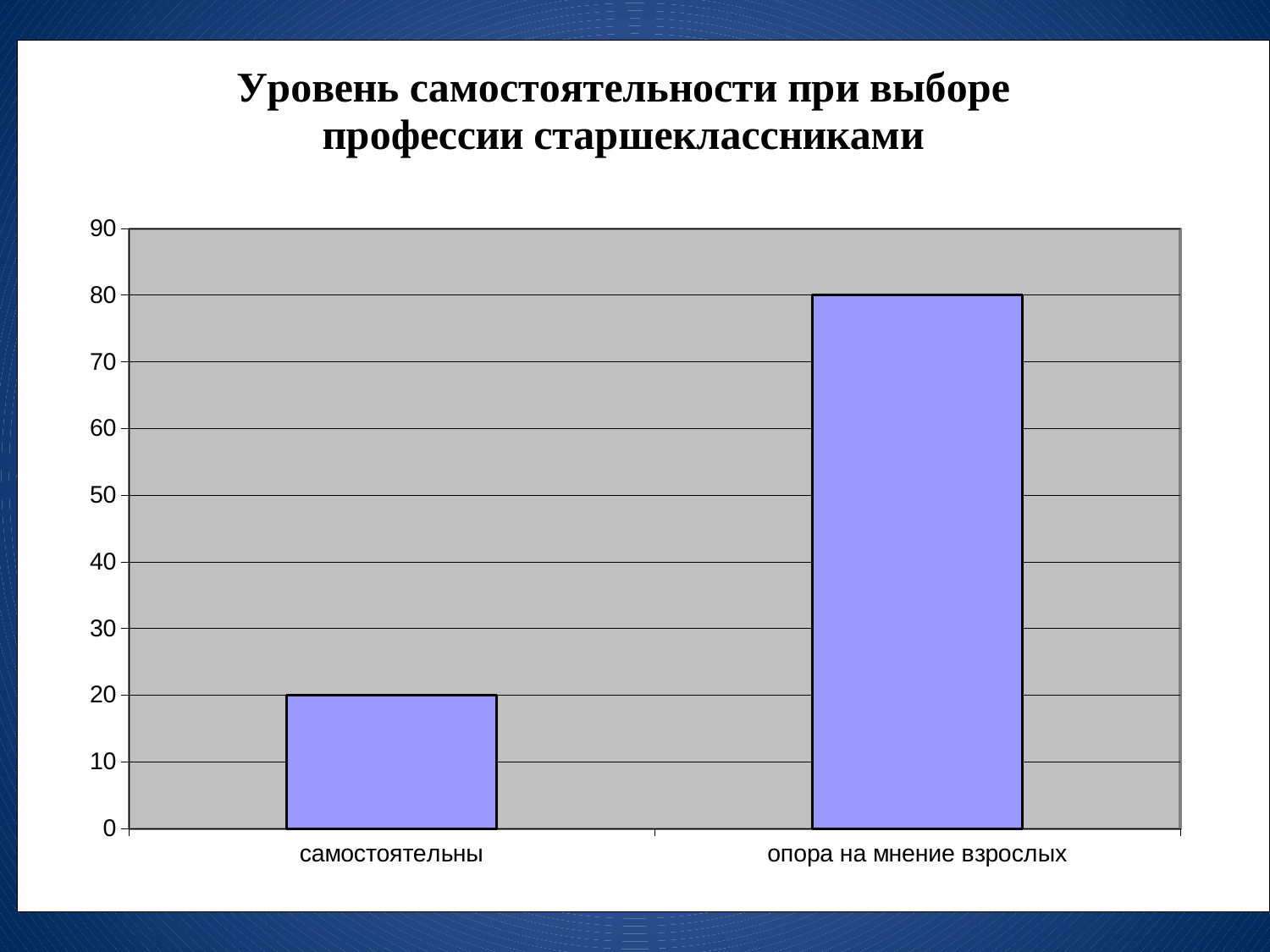
What is the difference between the values for "опора на мнение взрослых" and "самостоятельны"? 60 What kind of chart is shown on the slide? bar chart Which category has the lowest value? самостоятельны What is the value for "самостоятельны"? 20 Is the value for "опора на мнение взрослых" greater or less than 50? greater How many categories are shown on the x axis? 2 What is the value for "опора на мнение взрослых"? 80 What is the title of the chart? Уровень самостоятельности при выборе профессии старшеклассниками Which is larger: the value for "самостоятельны" or the value for "опора на мнение взрослых"? опора на мнение взрослых What is the highest value shown on the vertical axis? 90 Is the value for "самостоятельны" greater or less than 30? less Which category has the highest value? опора на мнение взрослых